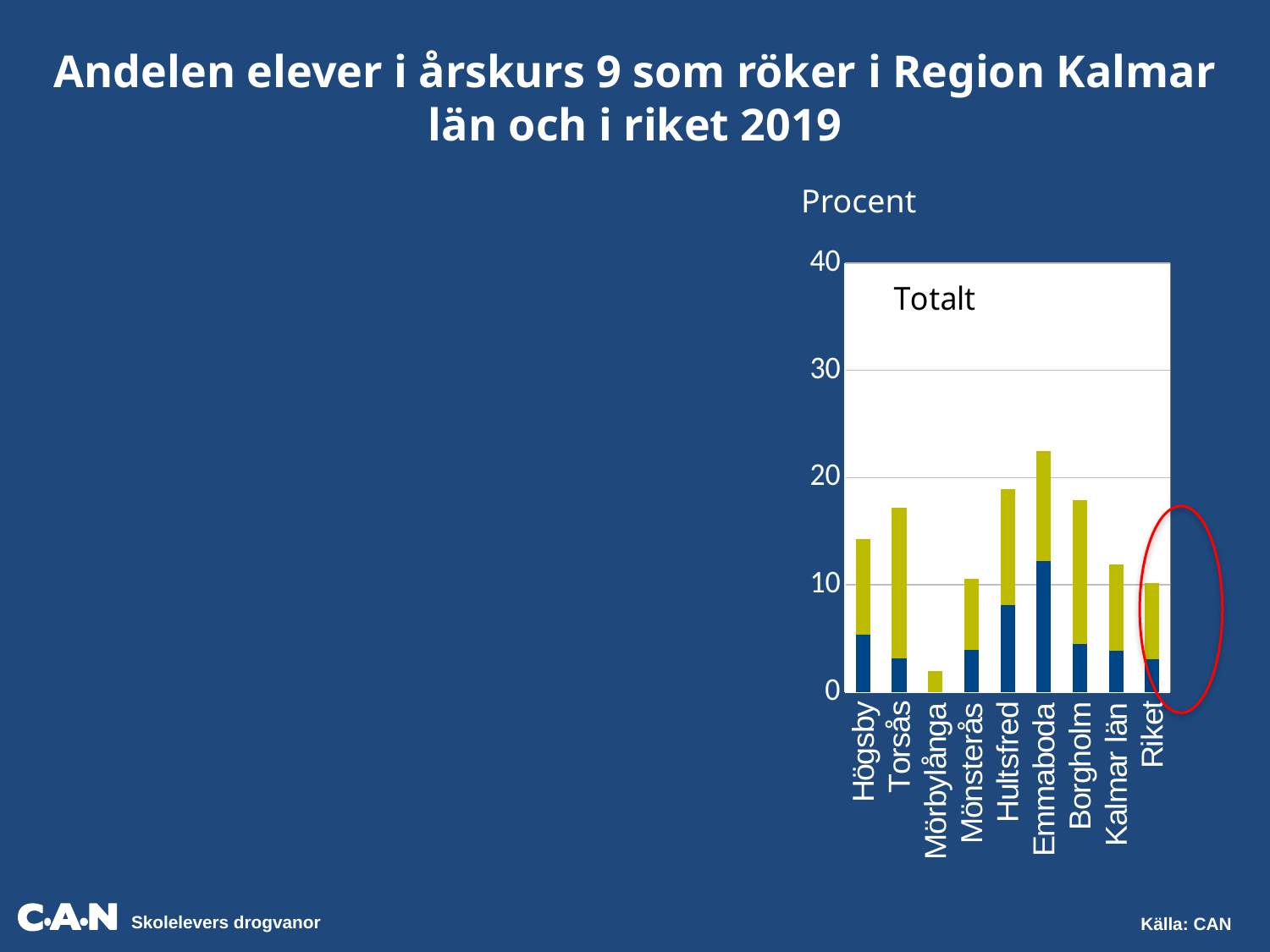
What kind of chart is shown on the slide? bar chart How many categories are shown on the x axis of the chart? 9 Is the total value for Emmaboda greater or less than 20? greater Which has the larger total bar, Emmaboda or Riket? Emmaboda Which category has the lowest total bar? Mörbylånga Which category's bar is circled in red on the chart? Riket Is the total value for Borgholm greater or less than 20? less What is the label shown above the y axis of the chart? Procent Is the total value for Torsås greater or less than 10? greater Which has the larger total bar, Torsås or Högsby? Torsås Which category has the highest total bar? Emmaboda